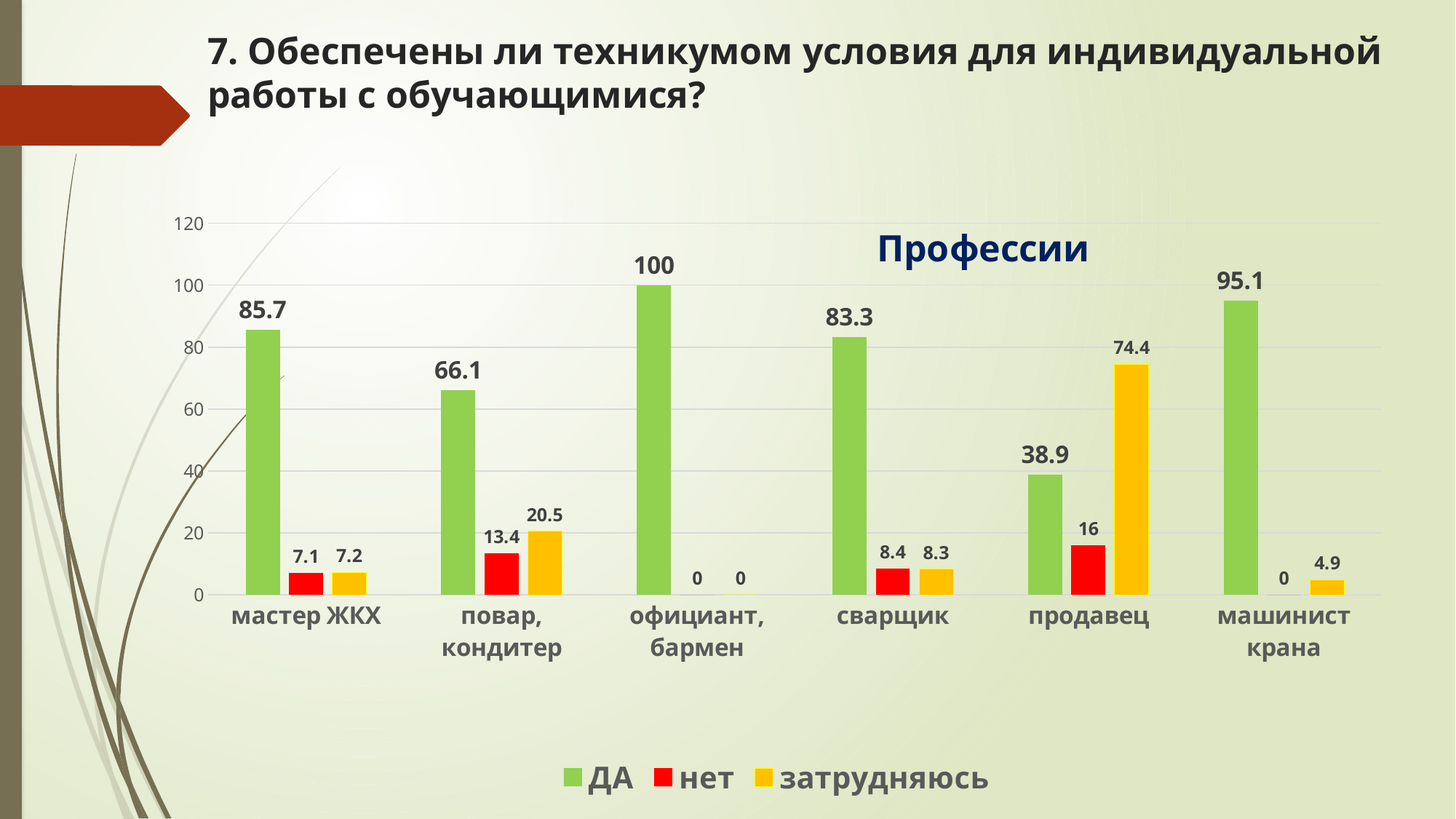
Which colour represents the нет series? red Which is larger for продавец: the нет value or the затрудняюсь value? затрудняюсь How many professions are shown on the x axis? 6 How many series does the legend list? 3 What is the difference between the ДА values for машинист крана and сварщик? 11.8 What is the value of нет for повар, кондитер? 13.4 What is the value of ДА for мастер ЖКХ? 85.7 What is the value of затрудняюсь for продавец? 74.4 Which profession has the highest ДА value? официант, бармен What kind of chart is shown on the slide? bar chart Which profession has the lowest ДА value? продавец Is the ДА value for повар, кондитер greater or less than 60? greater